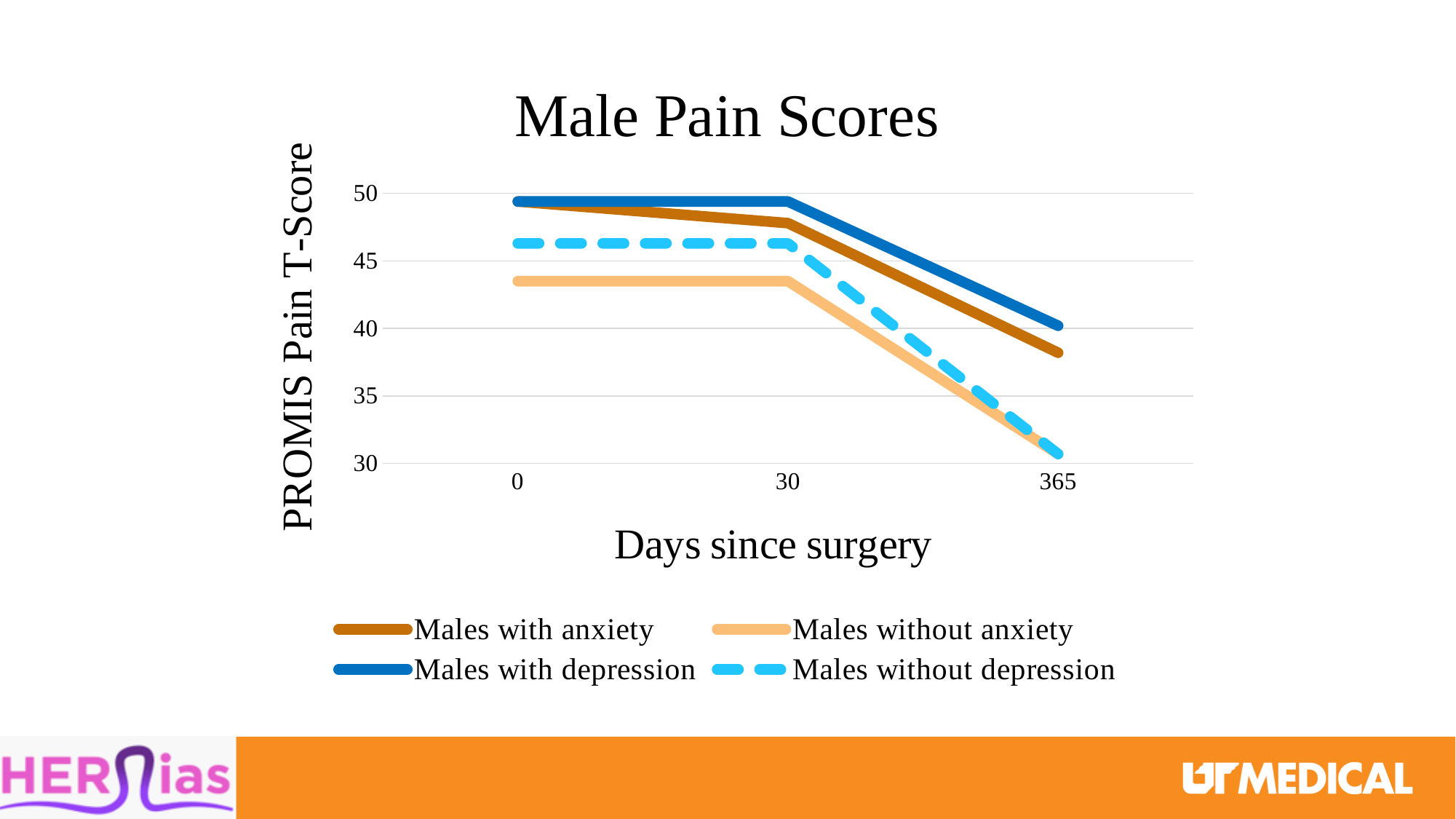
How many points on the x axis (days since surgery) are plotted for each series? 3 Which series has the lowest value at 0 days since surgery? Males without anxiety Which series has the highest value at 365 days since surgery? Males with depression Is the value for Males with anxiety at 365 days greater or less than 40? less What is the title of the chart? Male Pain Scores What kind of chart is shown on the slide? line chart How many series does the legend list? 4 At 30 days since surgery, which is larger: Males with depression or Males with anxiety? Males with depression Is the value for Males without anxiety at 0 days greater or less than 45? less Is the value for Males without depression at 0 days greater or less than 45? greater What is the label of the y axis? PROMIS Pain T-Score Do the values for Males with depression rise or fall from 30 days to 365 days since surgery? fall